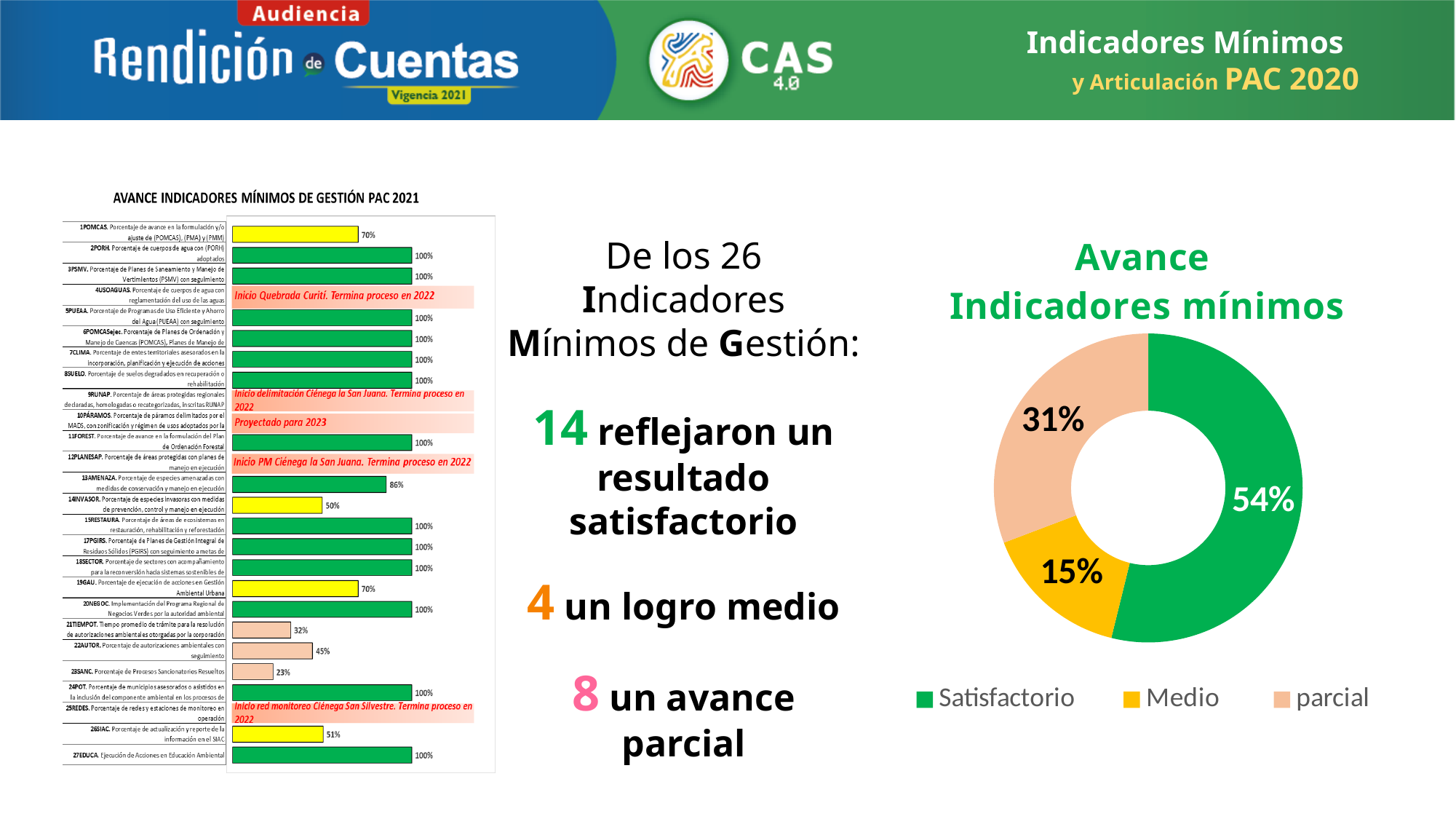
In the doughnut chart 'Avance Indicadores mínimos', which category has the smallest share? Medio In the doughnut chart 'Avance Indicadores mínimos', what percentage is shown for Satisfactorio? 54% What kind of chart is the chart on the left titled 'AVANCE INDICADORES MÍNIMOS DE GESTIÓN PAC 2021'? Bar chart What kind of chart is the chart on the right of the slide titled 'Avance Indicadores mínimos'? Doughnut chart In the doughnut chart 'Avance Indicadores mínimos', what percentage is shown for Medio? 15% In the bar chart 'AVANCE INDICADORES MÍNIMOS DE GESTIÓN PAC 2021', what value is shown for 23SANC? 23% In the doughnut chart 'Avance Indicadores mínimos', what is the difference in percentage points between Satisfactorio and parcial? 23 In the bar chart 'AVANCE INDICADORES MÍNIMOS DE GESTIÓN PAC 2021', what value is shown for 13AMENAZA? 86% In the bar chart 'AVANCE INDICADORES MÍNIMOS DE GESTIÓN PAC 2021', which is larger, the value for 21TIEMPOT or the value for 22AUTOR? 22AUTOR In the doughnut chart 'Avance Indicadores mínimos', how many categories does the legend list? 3 In the doughnut chart 'Avance Indicadores mínimos', which category has the largest share? Satisfactorio In the doughnut chart 'Avance Indicadores mínimos', what percentage is shown for parcial? 31%